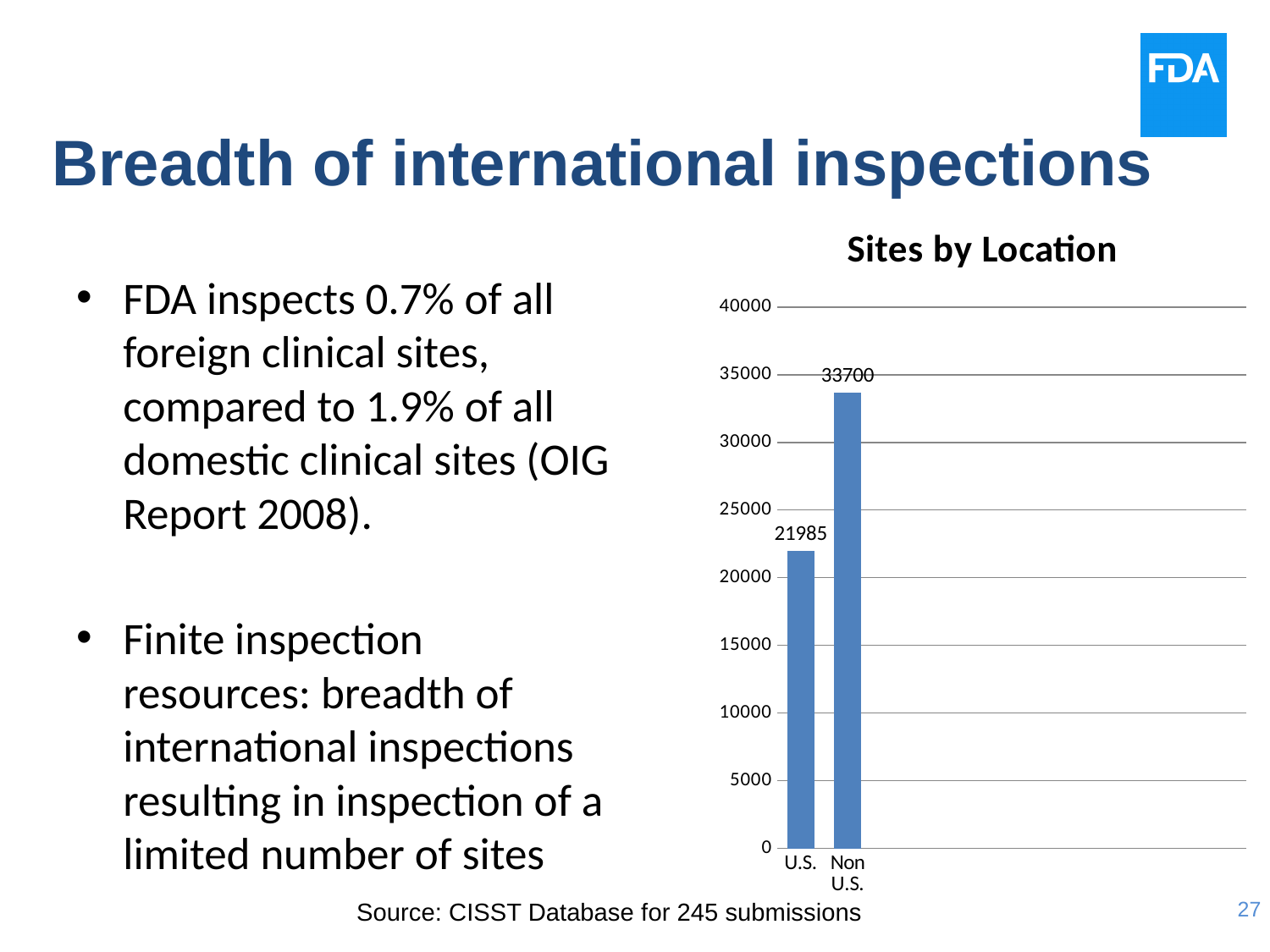
Which is larger in the Sites by Location chart, U.S. or Non U.S.? Non U.S. What is the value for U.S. in the Sites by Location chart? 21985 Is the value for U.S. greater or less than 25000? less Which category has the highest value in the Sites by Location chart? Non U.S. Which category has the lowest value in the Sites by Location chart? U.S. What is the total of the U.S. and Non U.S. values in the Sites by Location chart? 55685 What is the difference between the Non U.S. and U.S. values in the Sites by Location chart? 11715 What is the title of the chart on the slide? Sites by Location Is the value for Non U.S. greater or less than 30000? greater What kind of chart is the Sites by Location chart? bar chart How many categories are shown in the Sites by Location chart? 2 What is the value for Non U.S. in the Sites by Location chart? 33700